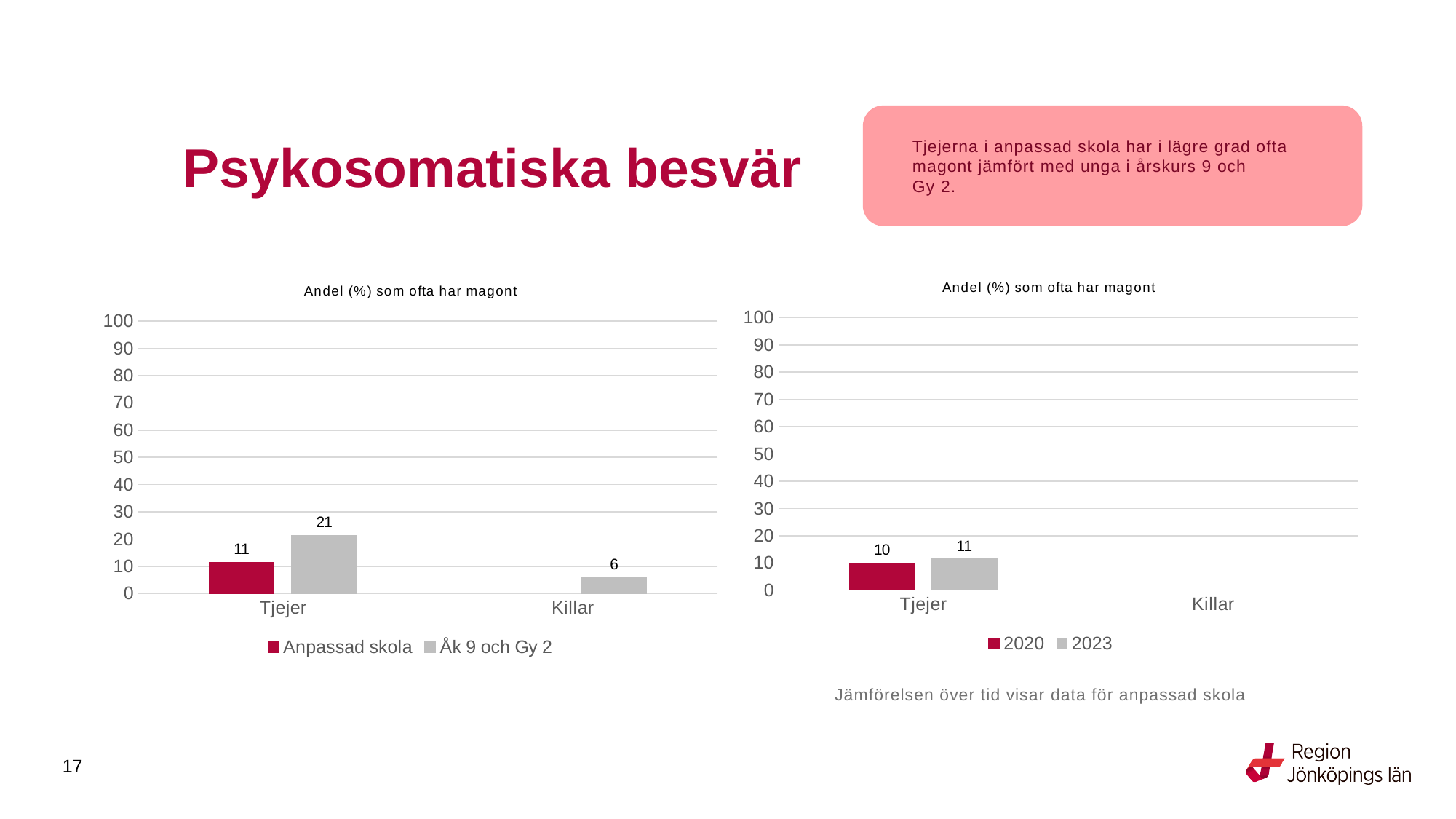
In the right chart, what is the value for 2023 among Tjejer? 11 In the left chart, what is the difference between Åk 9 och Gy 2 and Anpassad skola for Tjejer? 10 In the left chart, what is the value for Åk 9 och Gy 2 among Tjejer? 21 In the left chart, which bar has the highest value? Åk 9 och Gy 2 for Tjejer How many series does the legend of the left chart list? 2 In the right chart, what is the difference between the 2023 and 2020 values for Tjejer? 1 In the left chart, what is the value for Åk 9 och Gy 2 among Killar? 6 What kind of chart is the right chart? Bar chart In the left chart, what is the value for Anpassad skola among Tjejer? 11 In the left chart, which series has the higher value for Tjejer, Anpassad skola or Åk 9 och Gy 2? Åk 9 och Gy 2 In the right chart, what is the value for 2020 among Tjejer? 10 What is the title of the left chart? Andel (%) som ofta har magont